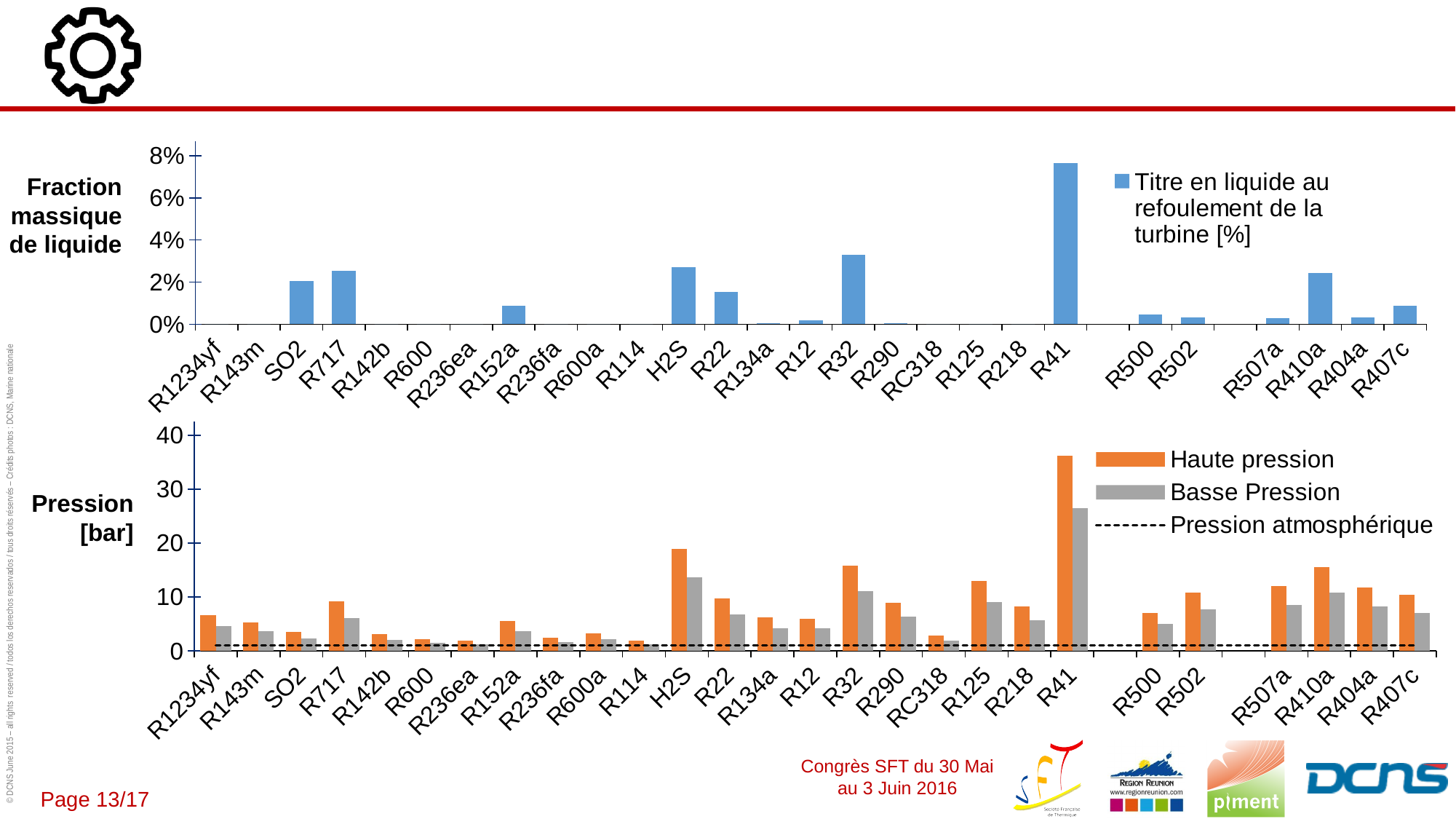
In the top chart (Fraction massique de liquide), is the value for R41 greater or less than 6%? greater In the top chart (Fraction massique de liquide), is the value for R22 greater or less than 2%? less In the bottom chart (Pression [bar]), is the Basse Pression for R41 greater or less than 20? greater How many refrigerant categories are shown on the x axis of the bottom chart (Pression [bar])? 27 In the bottom chart (Pression [bar]), which has the larger Haute pression, H2S or R32? H2S In the top chart (Fraction massique de liquide), which refrigerant has the highest liquid fraction? R41 What kind of chart is the top chart (Fraction massique de liquide)? bar chart How many entries does the legend of the bottom chart (Pression [bar]) list? 3 In the bottom chart (Pression [bar]), which refrigerant has the highest Haute pression? R41 In the bottom chart (Pression [bar]), what colour are the Haute pression bars? orange